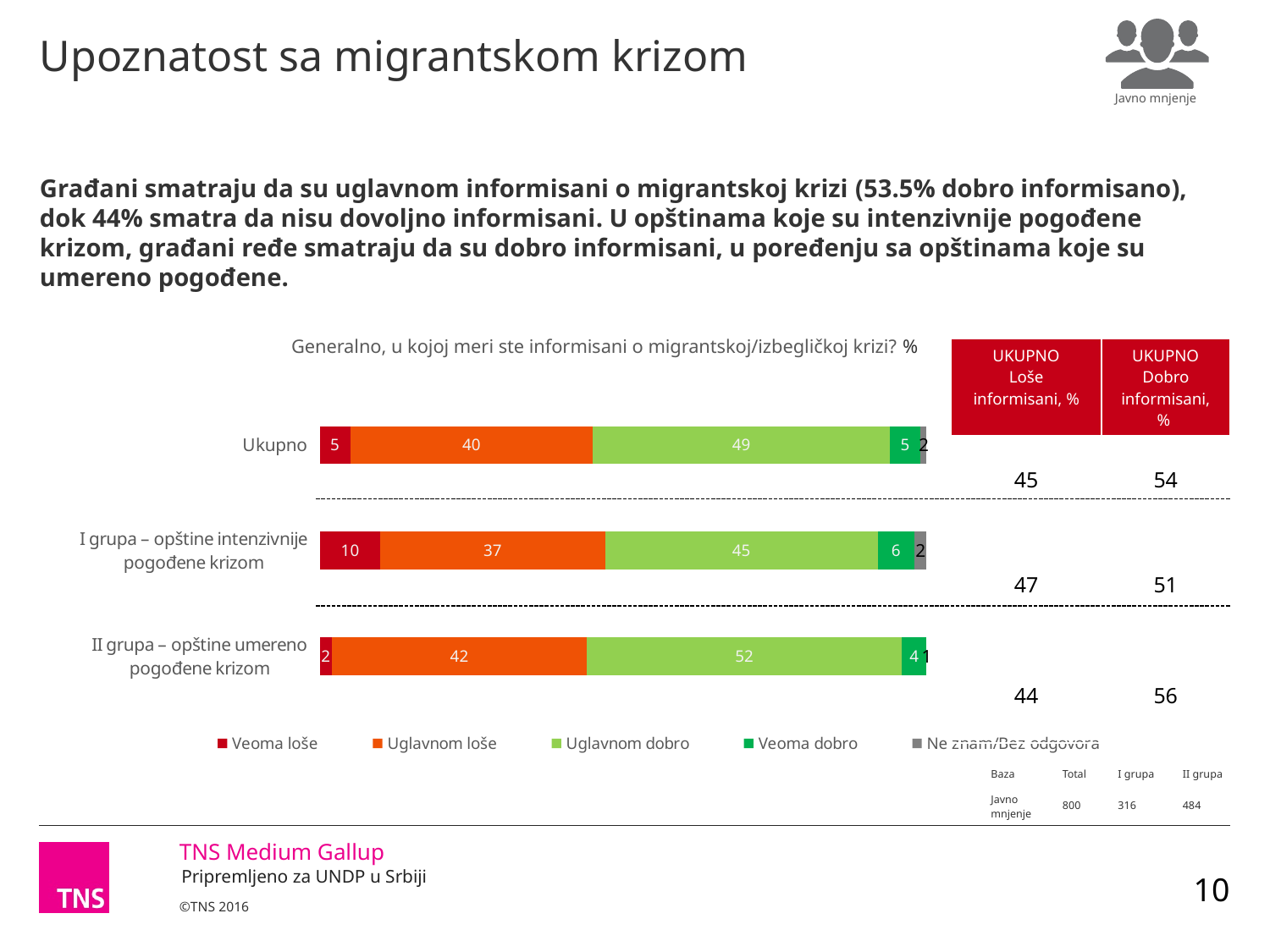
What is the title of the chart? Generalno, u kojoj meri ste informisani o migrantskoj/izbegličkoj krizi? % What is the value of 'Uglavnom dobro' for 'Ukupno'? 49 What is the difference between the 'Uglavnom dobro' values for 'II grupa' and 'I grupa'? 7 What is the total of the 'Veoma loše' and 'Uglavnom loše' segments for 'I grupa – opštine intenzivnije pogođene krizom'? 47 What type of chart is shown on the slide? stacked bar chart What is the value of 'Veoma loše' for 'I grupa – opštine intenzivnije pogođene krizom'? 10 How many series does the chart legend list? 5 Which is larger: the 'Uglavnom loše' value for 'Ukupno' or for 'I grupa'? Ukupno Which category has the lowest value for 'Veoma loše'? II grupa – opštine umereno pogođene krizom Which category has the highest value for 'Uglavnom dobro'? II grupa – opštine umereno pogođene krizom How many categories (groups) are plotted in the chart? 3 What is the value of 'Uglavnom loše' for 'II grupa – opštine umereno pogođene krizom'? 42